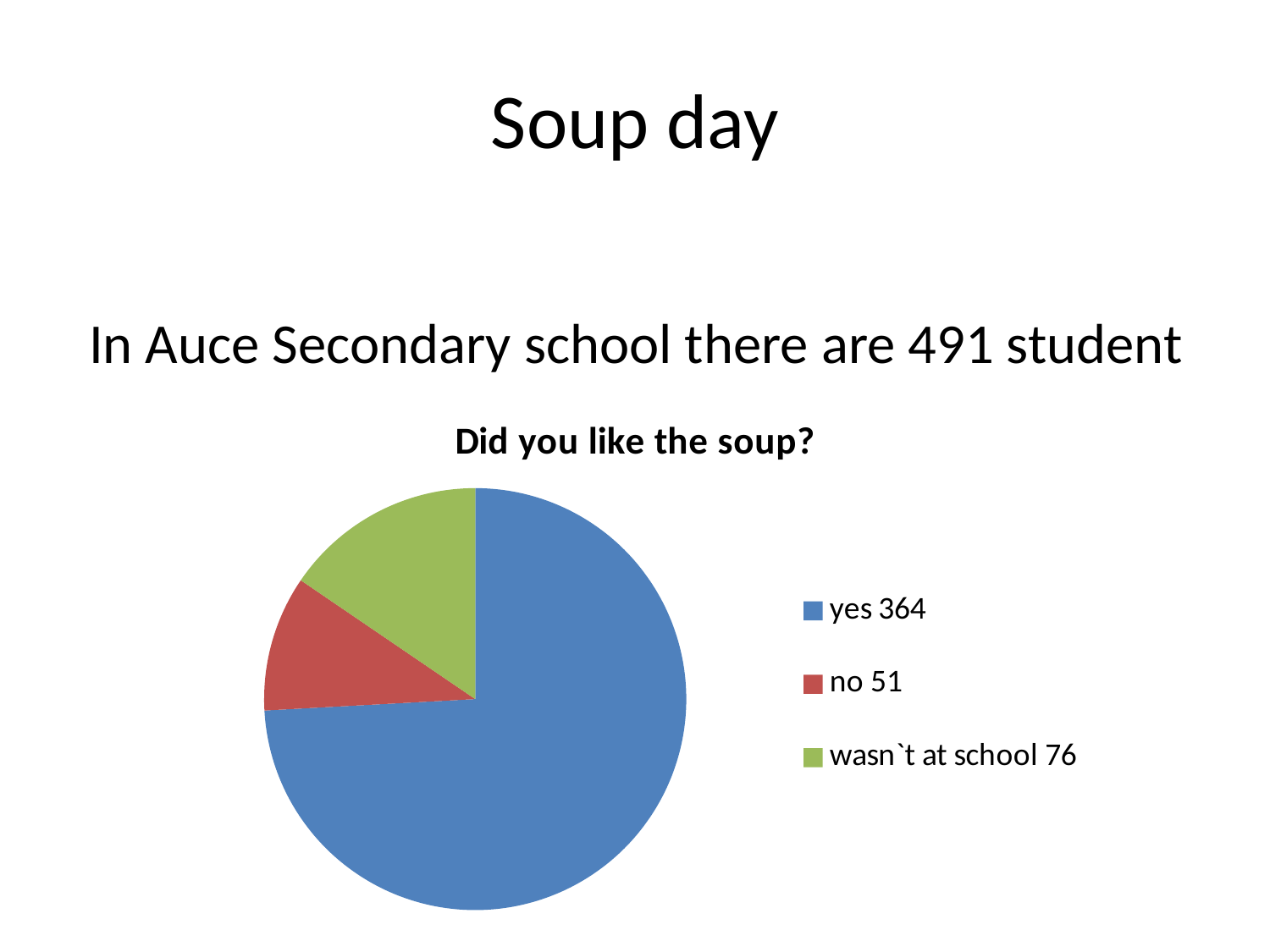
Which is larger: the number who answered "no" or the number who weren't at school? wasn`t at school What is the difference between the number who answered "yes" and the number who answered "no"? 313 What is the difference between the number who weren't at school and the number who answered "no"? 25 What colour is the slice for "yes"? blue How many slices does the pie chart have? 3 What is the title of the chart? Did you like the soup? How many students answered "no" according to the legend? 51 How many students weren't at school according to the legend? 76 What kind of chart is shown on the slide? pie chart How many students answered "yes" according to the legend? 364 Which category has the smallest slice of the pie? no Which category has the largest slice of the pie? yes